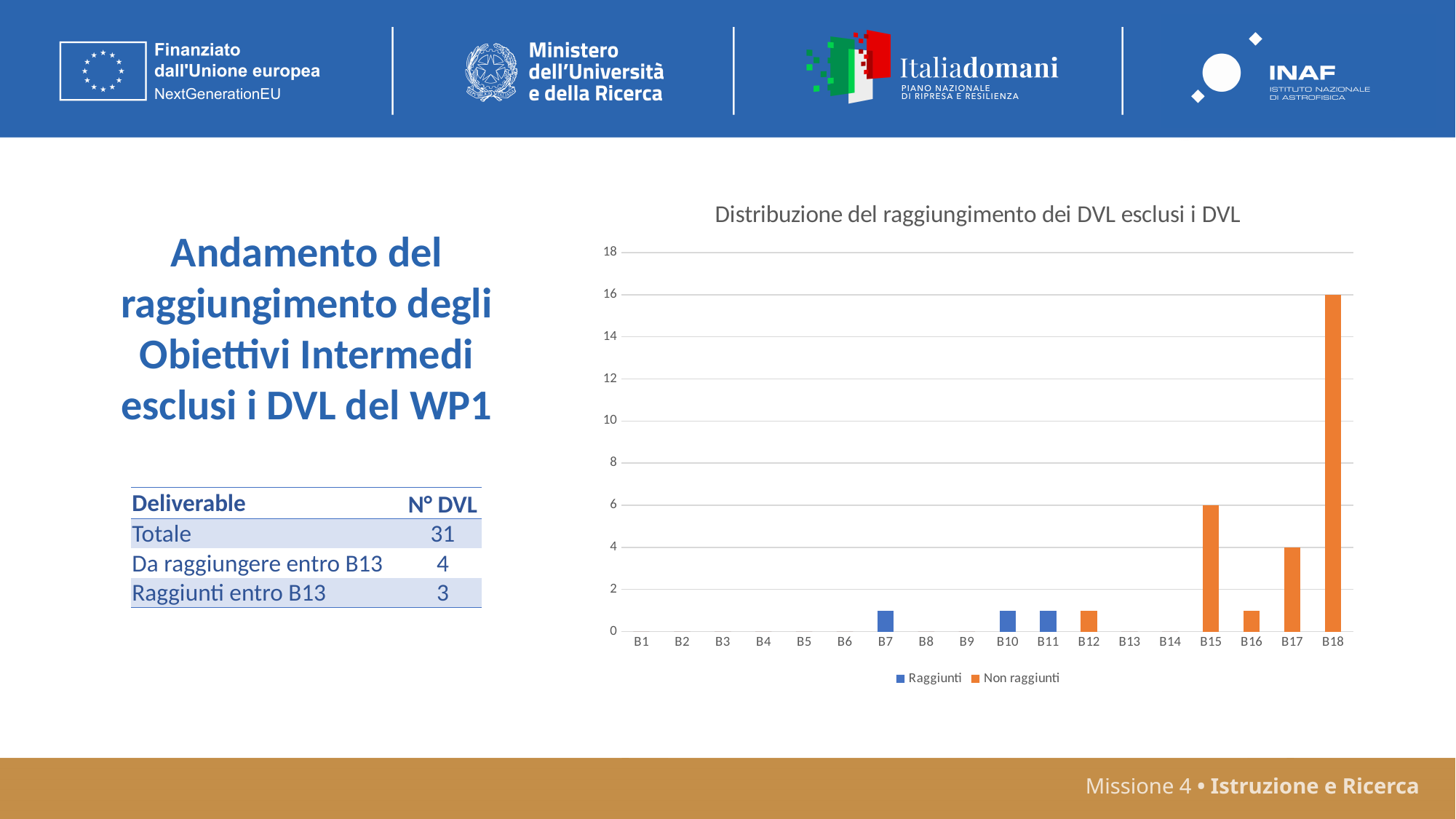
Which is larger, the Non raggiunti value for B15 or for B17? B15 Which colour represents the Non raggiunti series in the chart? orange Is the Raggiunti value for B7 greater or less than 2? less What is the value of Non raggiunti for B18? 16 How many categories are shown on the x axis of the chart? 18 What is the value of Non raggiunti for B15? 6 What is the title of the chart? Distribuzione del raggiungimento dei DVL esclusi i DVL What is the value of Non raggiunti for B17? 4 Which category has the highest bar in the chart? B18 What kind of chart is shown on the slide? bar chart How many series does the chart legend list? 2 What is the difference between the Non raggiunti values for B18 and B15? 10